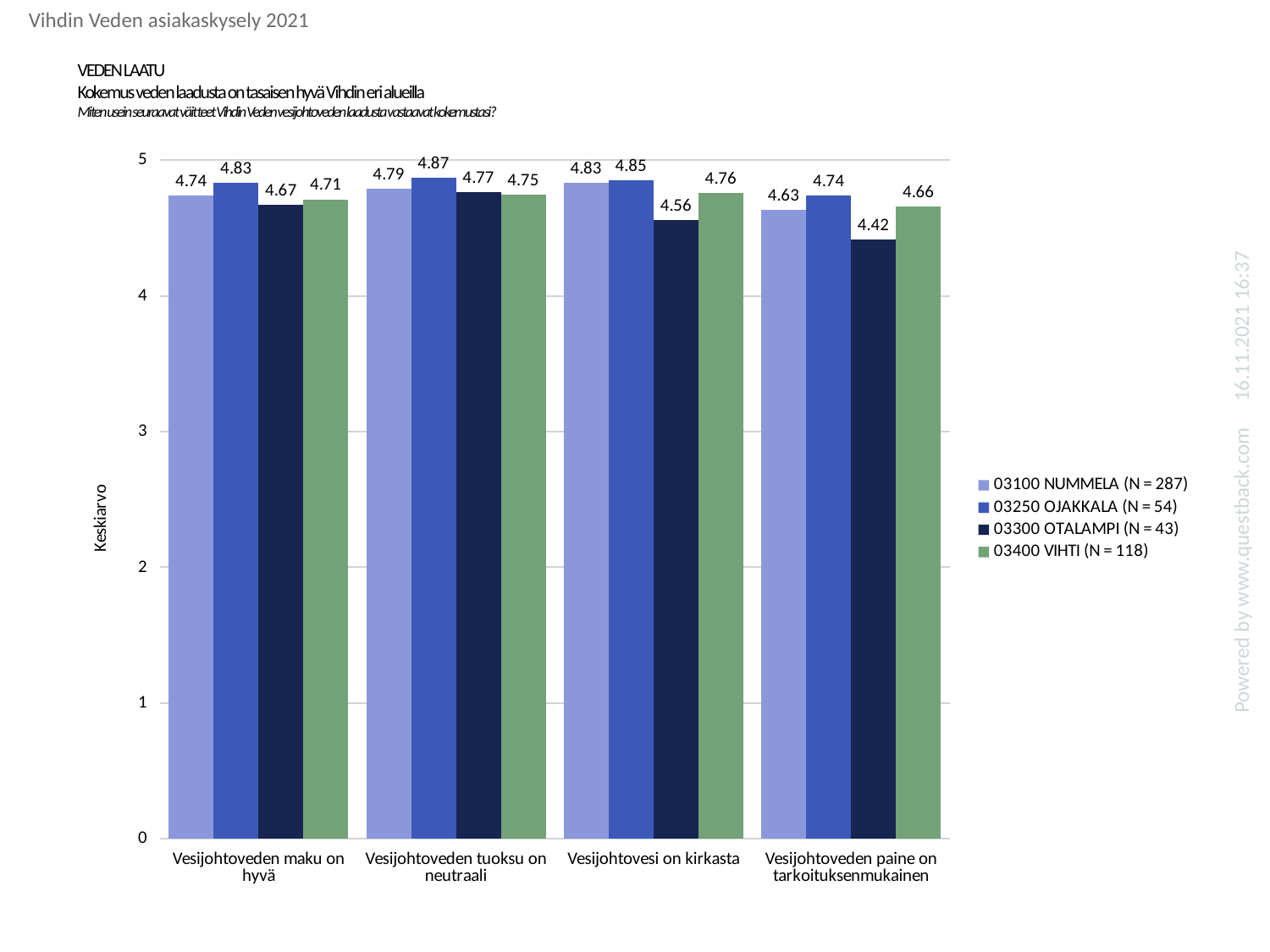
Which series has the lowest value in the category "Vesijohtoveden paine on tarkoituksenmukainen"? 03300 OTALAMPI (N = 43) What is the value for 03300 OTALAMPI in the category "Vesijohtoveden paine on tarkoituksenmukainen"? 4.42 Which series has the highest value in the category "Vesijohtovesi on kirkasta"? 03250 OJAKKALA (N = 54) What is the value for 03100 NUMMELA in the category "Vesijohtoveden maku on hyvä"? 4.74 What is the difference between the 03250 OJAKKALA and 03300 OTALAMPI values in the category "Vesijohtovesi on kirkasta"? 0.29 Which is larger for 03400 VIHTI: the value for "Vesijohtoveden maku on hyvä" or for "Vesijohtoveden tuoksu on neutraali"? Vesijohtoveden tuoksu on neutraali How many categories are shown on the x axis? 4 How many series does the legend list? 4 What kind of chart is shown on the slide? Bar chart What is the value for 03250 OJAKKALA in the category "Vesijohtoveden tuoksu on neutraali"? 4.87 What is the label of the y axis? Keskiarvo What is the value for 03400 VIHTI in the category "Vesijohtovesi on kirkasta"? 4.76